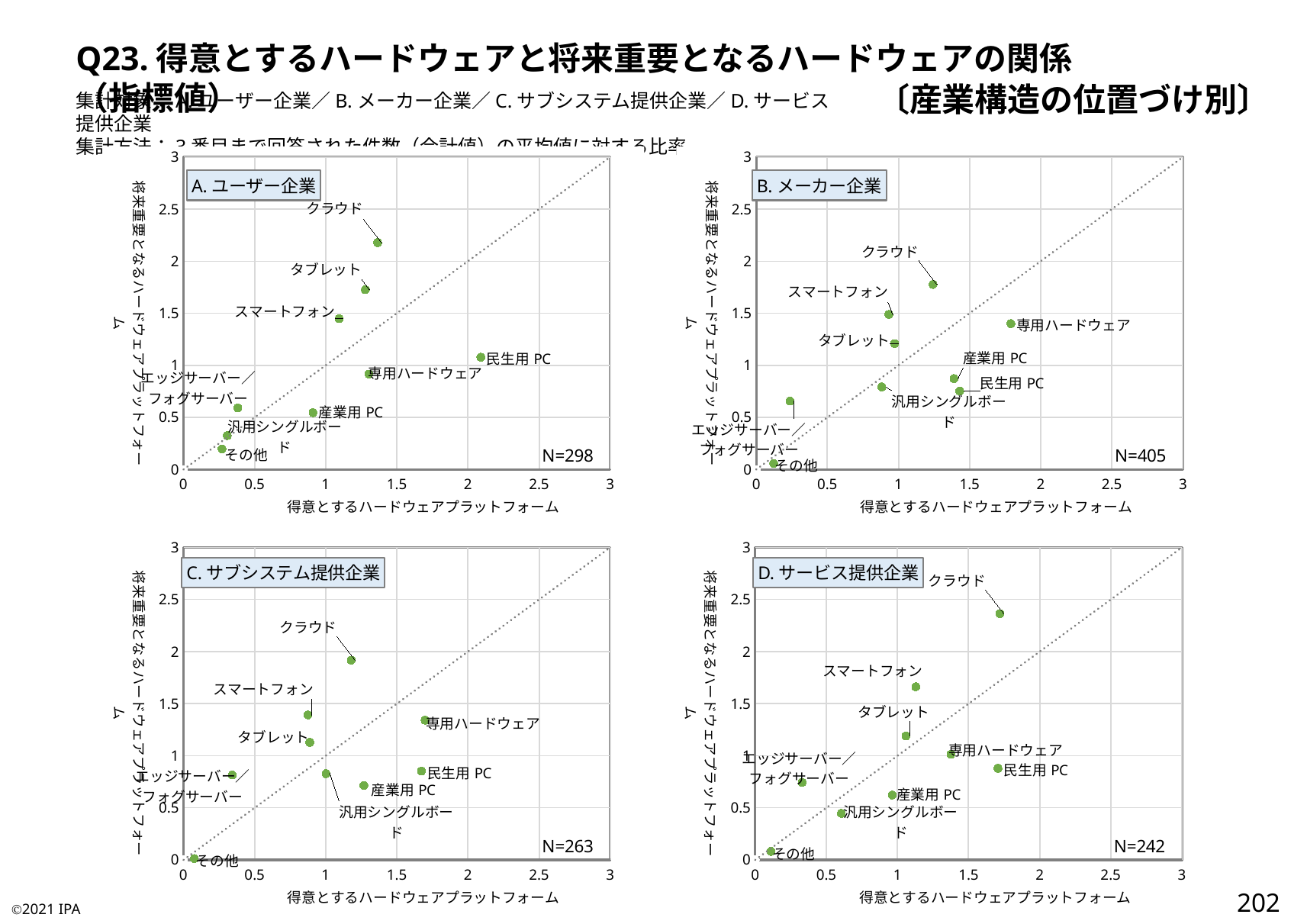
In the chart titled D. サービス提供企業, is the vertical-axis value for クラウド greater or less than 2? greater In the chart titled B. メーカー企業, is the vertical-axis value for クラウド greater or less than 1.5? greater In the chart titled A. ユーザー企業, which hardware has the highest value on the vertical axis (将来重要となるハードウェアプラットフォーム)? クラウド In the chart titled A. ユーザー企業, is the horizontal-axis value for 民生用 PC greater or less than 2? greater In the chart titled C. サブシステム提供企業, which has the higher vertical-axis value, クラウド or スマートフォン? クラウド In the chart titled B. メーカー企業, which hardware has the lowest value on the vertical axis? その他 In the chart titled B. メーカー企業, which hardware has the highest value on the horizontal axis (得意とするハードウェアプラットフォーム)? 専用ハードウェア In the chart titled D. サービス提供企業, which has the higher horizontal-axis value, 民生用 PC or 汎用シングルボード? 民生用 PC What is the N value shown in the chart titled B. メーカー企業? N=405 In the chart titled A. ユーザー企業, how many data points are plotted? 9 What kind of chart is used in the four panels on this slide? scatter chart